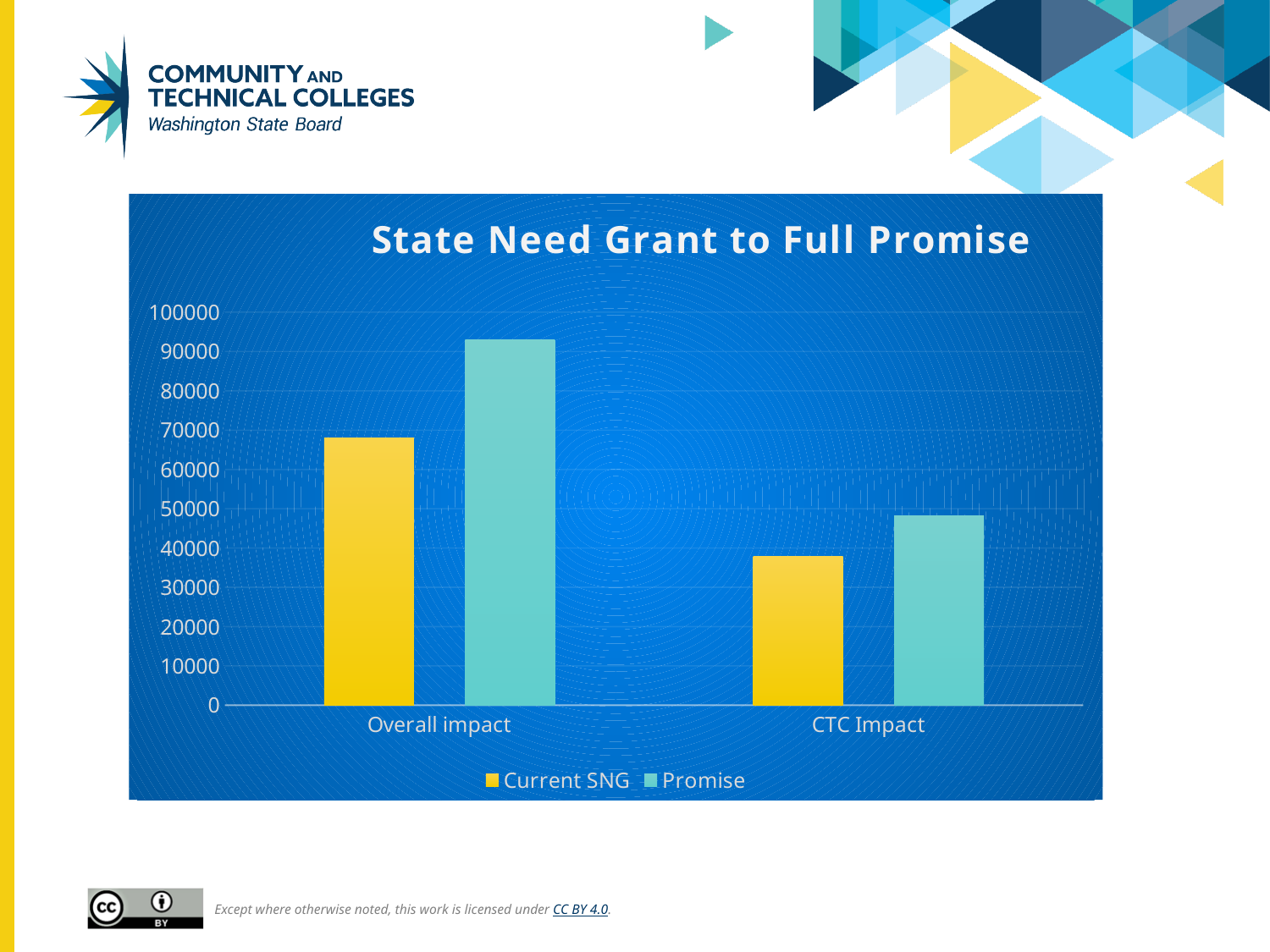
Which bar is the shortest in the chart? Current SNG for CTC Impact Is the Current SNG value for Overall impact greater or less than 60000? greater Is the Promise value for CTC Impact greater or less than 40000? greater How many categories are shown on the x axis? 2 What is the title of the chart? State Need Grant to Full Promise What type of chart is shown on the slide? Bar chart Is the Promise value for Overall impact greater or less than 90000? greater Which bar is the tallest in the chart? Promise for Overall impact For Overall impact, which series has the larger value, Current SNG or Promise? Promise How many series does the legend list? 2 Which series is shown in yellow? Current SNG